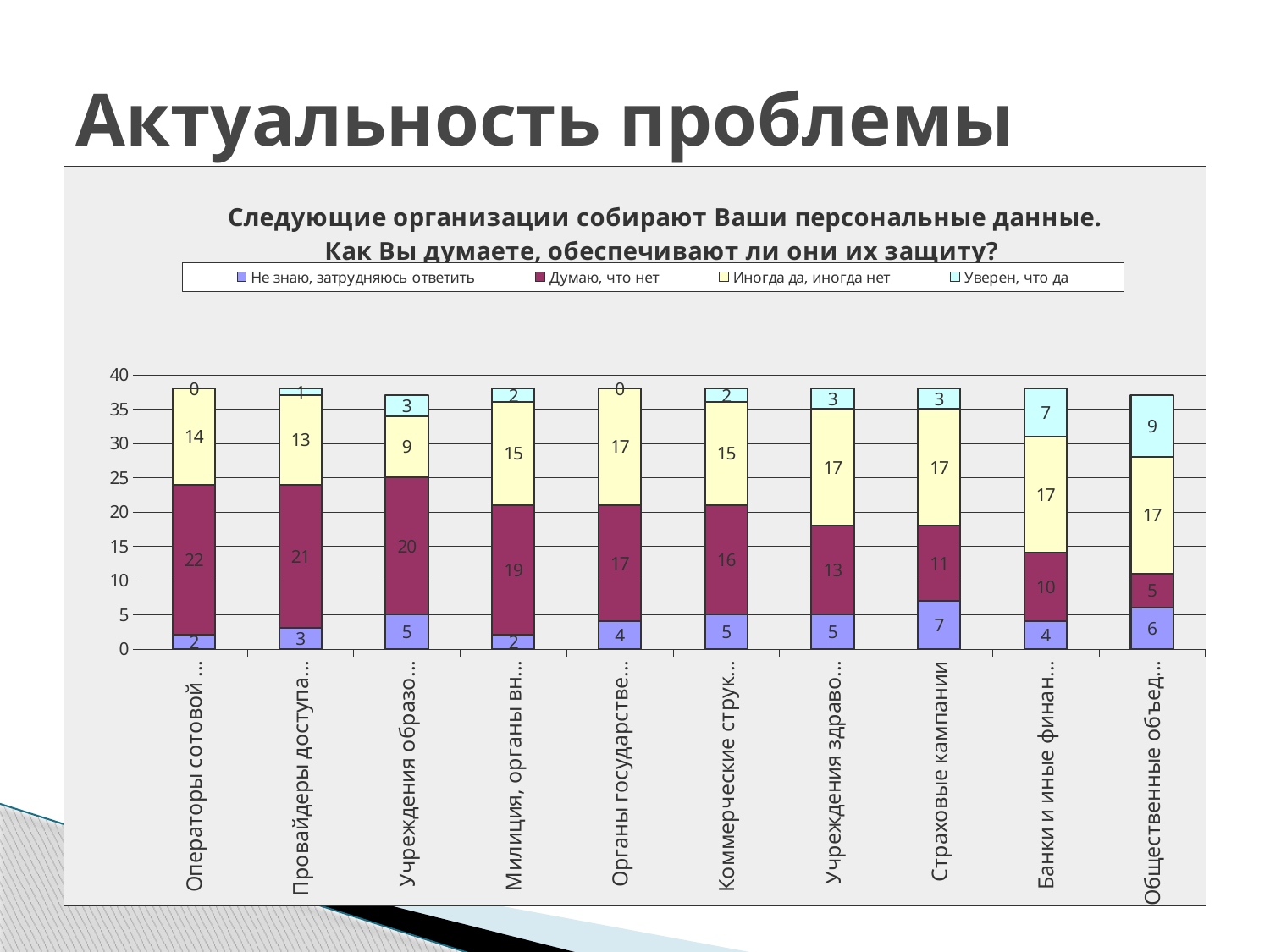
For 'Страховые кампании', what is the difference between the 'Иногда да, иногда нет' segment and the 'Думаю, что нет' segment? 6 How many categories (organisations) are plotted along the x axis? 10 Which category has the highest 'Думаю, что нет' value? The leftmost category (Операторы сотовой…), with 22 What is the value of the 'Не знаю, затрудняюсь ответить' segment for 'Страховые кампании'? 7 Do the 'Думаю, что нет' values rise or fall moving from left to right along the x axis? Fall For 'Страховые кампании', which is larger: the 'Не знаю, затрудняюсь ответить' segment or the 'Уверен, что да' segment? Не знаю, затрудняюсь ответить How many series does the legend list? 4 What is the total of the stacked bar for 'Страховые кампании'? 38 What is the first entry listed in the chart legend? Не знаю, затрудняюсь ответить What is the value of the 'Уверен, что да' segment for 'Страховые кампании'? 3 What kind of chart is shown on the slide? Stacked bar chart What is the value of the 'Думаю, что нет' segment for 'Страховые кампании'? 11